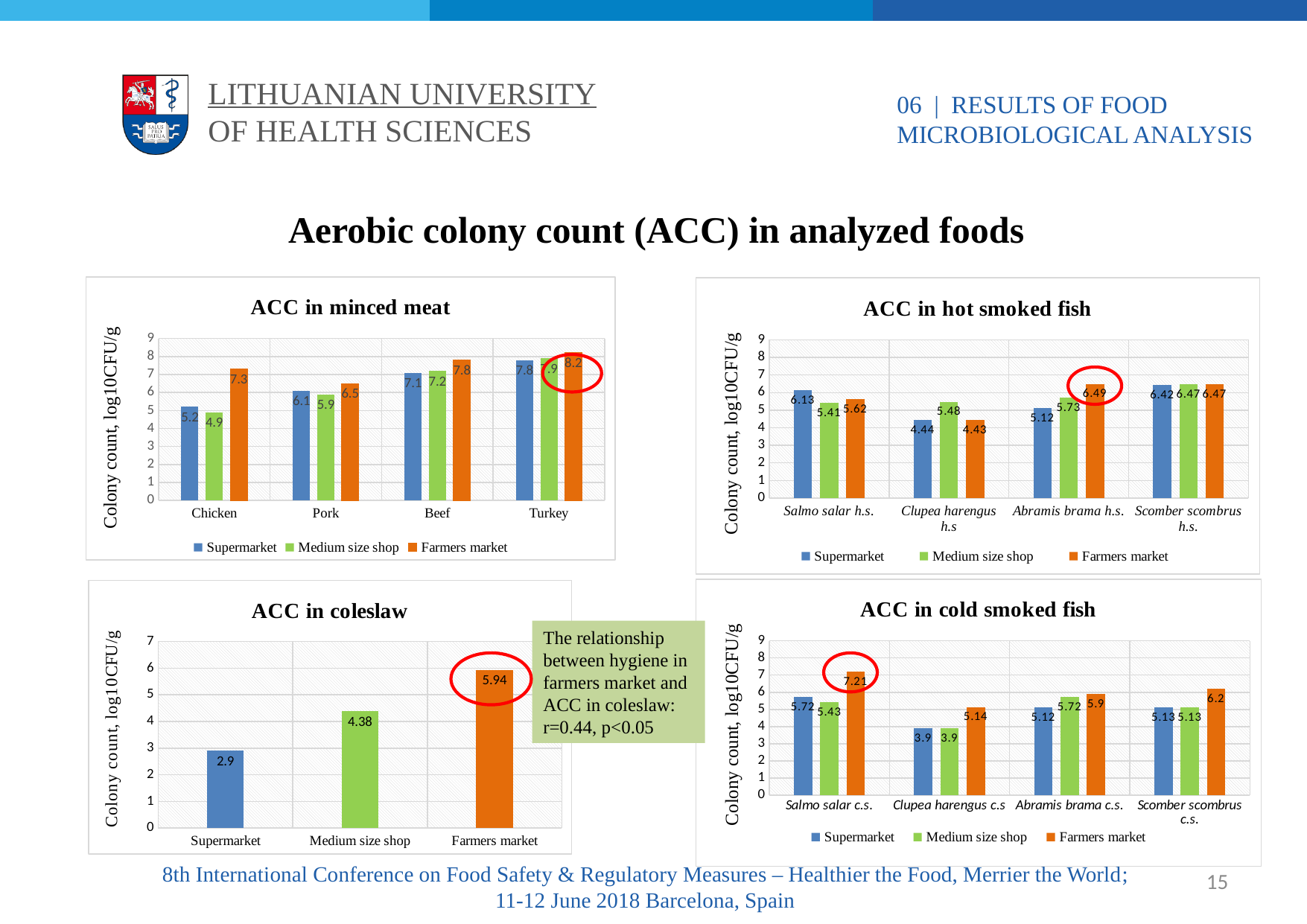
In the 'ACC in hot smoked fish' chart, is the Supermarket value for Salmo salar h.s. larger or smaller than the Medium size shop value? larger In the 'ACC in coleslaw' chart, how many categories are shown? 3 In the 'ACC in hot smoked fish' chart, what is the Farmers market value for Abramis brama h.s.? 6.49 How many series does the legend of the 'ACC in cold smoked fish' chart list? 3 In the 'ACC in coleslaw' chart, do the values rise or fall from Supermarket to Farmers market? rise In the 'ACC in hot smoked fish' chart, which series has the lowest value for Clupea harengus h.s? Farmers market In the 'ACC in minced meat' chart, what is the difference between the Farmers market and Supermarket values for Chicken? 2.1 In the 'ACC in cold smoked fish' chart, what is the Farmers market value for Salmo salar c.s.? 7.21 In the 'ACC in coleslaw' chart, what is the value for Medium size shop? 4.38 In the 'ACC in minced meat' chart, which category has the highest Farmers market value? Turkey In the 'ACC in cold smoked fish' chart, what is the difference between the Farmers market and Supermarket values for Clupea harengus c.s? 1.24 In the 'ACC in minced meat' chart, what is the Farmers market value for Chicken? 7.3